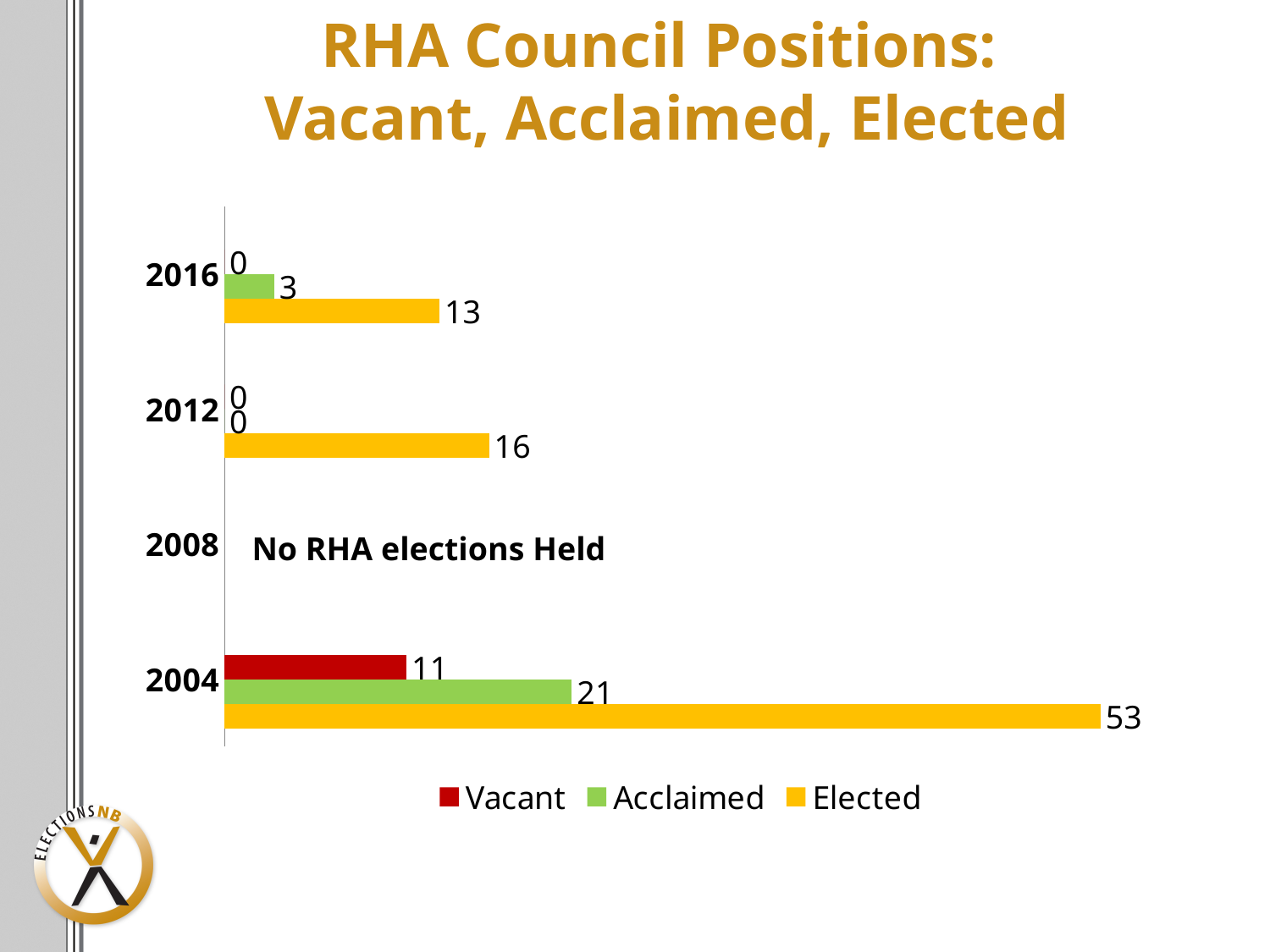
What note is shown for the year 2008 on the chart? No RHA elections Held How many Acclaimed positions were there in 2016? 3 What is the difference between Elected positions in 2004 and 2012? 37 How many Elected positions were there in 2012? 16 What is the Vacant value for 2004? 11 Which year shown with data has the lowest number of Elected positions? 2016 What is the number of Elected RHA council positions in 2004? 53 How many series does the legend list? 3 Which is larger in 2004, the Acclaimed value or the Vacant value? Acclaimed What type of chart is shown on the slide? Bar chart What is the total of Vacant, Acclaimed and Elected positions in 2004? 85 Which year has the highest number of Elected positions? 2004